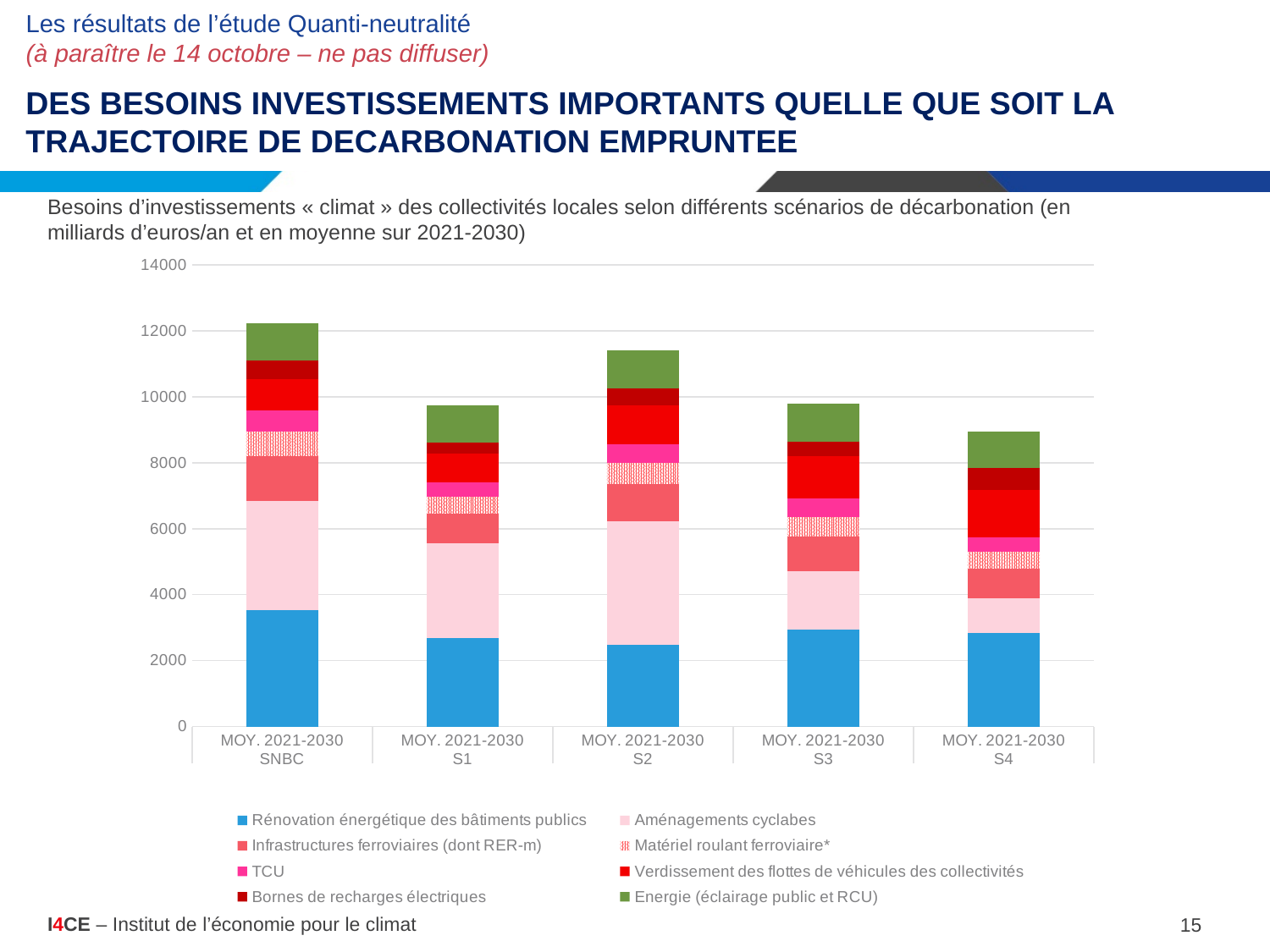
How many series does the legend list? 8 Is the total stacked bar for MOY. 2021-2030 SNBC greater or less than 10000? greater Which colour represents 'Rénovation énergétique des bâtiments publics' in the legend? Blue Is the total stacked bar for MOY. 2021-2030 S4 greater or less than 10000? less What kind of chart is shown on the slide? Stacked bar chart Which scenario has the lowest total stacked bar? MOY. 2021-2030 S4 Which has the larger 'Rénovation énergétique des bâtiments publics' segment: MOY. 2021-2030 SNBC or MOY. 2021-2030 S2? MOY. 2021-2030 SNBC Which scenario has the highest total stacked bar? MOY. 2021-2030 SNBC How many scenario categories are plotted along the x axis? 5 Which has the larger total stacked bar: MOY. 2021-2030 S2 or MOY. 2021-2030 S4? MOY. 2021-2030 S2 Is the 'Rénovation énergétique des bâtiments publics' segment for MOY. 2021-2030 SNBC greater or less than 2000? greater